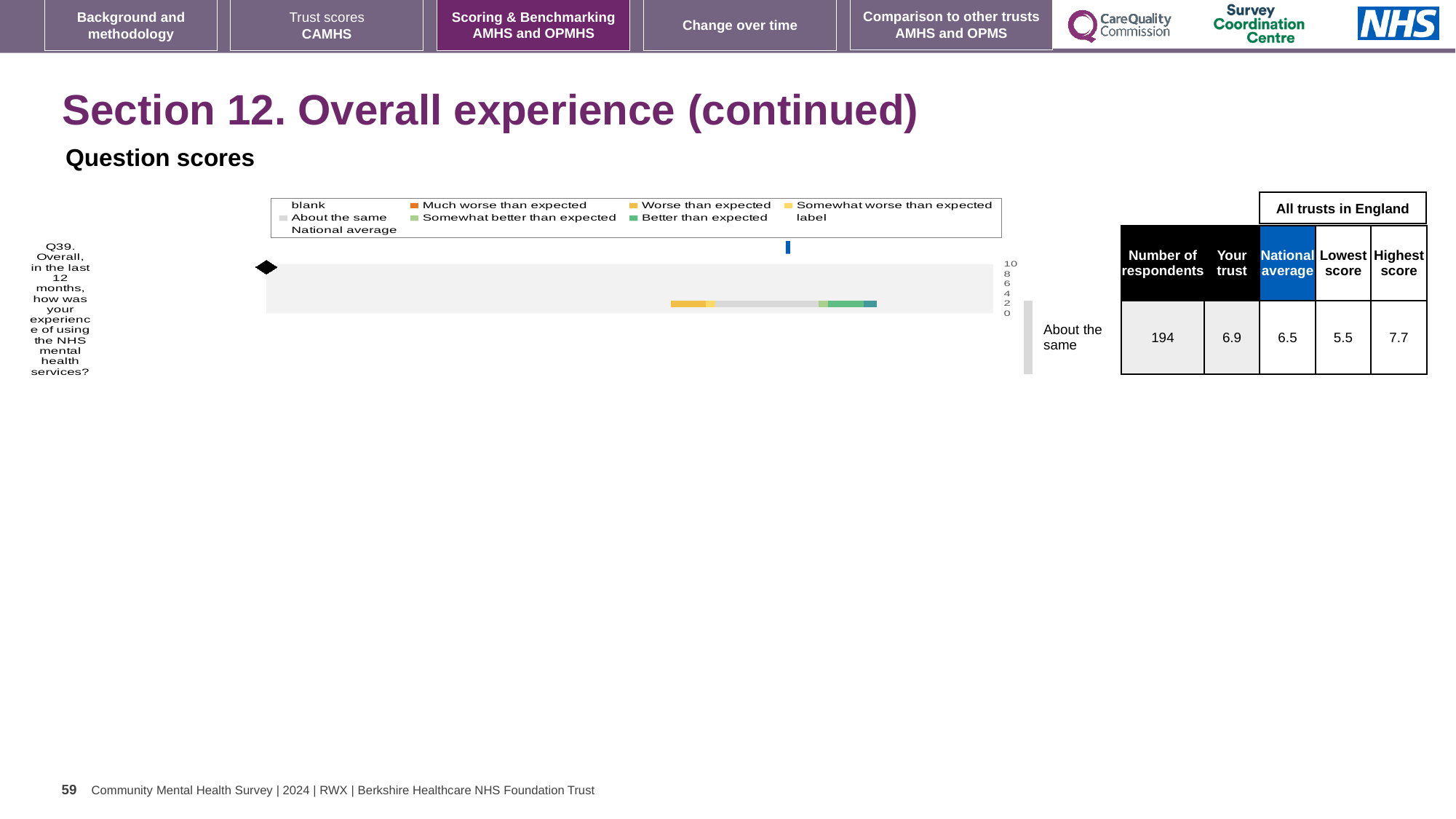
What is the 'Your trust' score for Q39 in the table next to the chart? 6.9 What is the difference between the highest and lowest scores for Q39 across all trusts in England? 2.2 How many entries does the chart legend list? 9 What is the highest score among all trusts in England for Q39? 7.7 What is the difference between the 'Your trust' score and the national average for Q39? 0.4 What is the national average score for Q39 in the table next to the chart? 6.5 How many respondents answered Q39? 194 What kind of chart is shown on the slide for Q39? bar chart Which is larger for Q39, the 'Your trust' score or the national average? Your trust What is the highest value shown on the chart's axis? 10 How many questions (categories) are plotted in the chart? 1 What is the lowest score among all trusts in England for Q39? 5.5